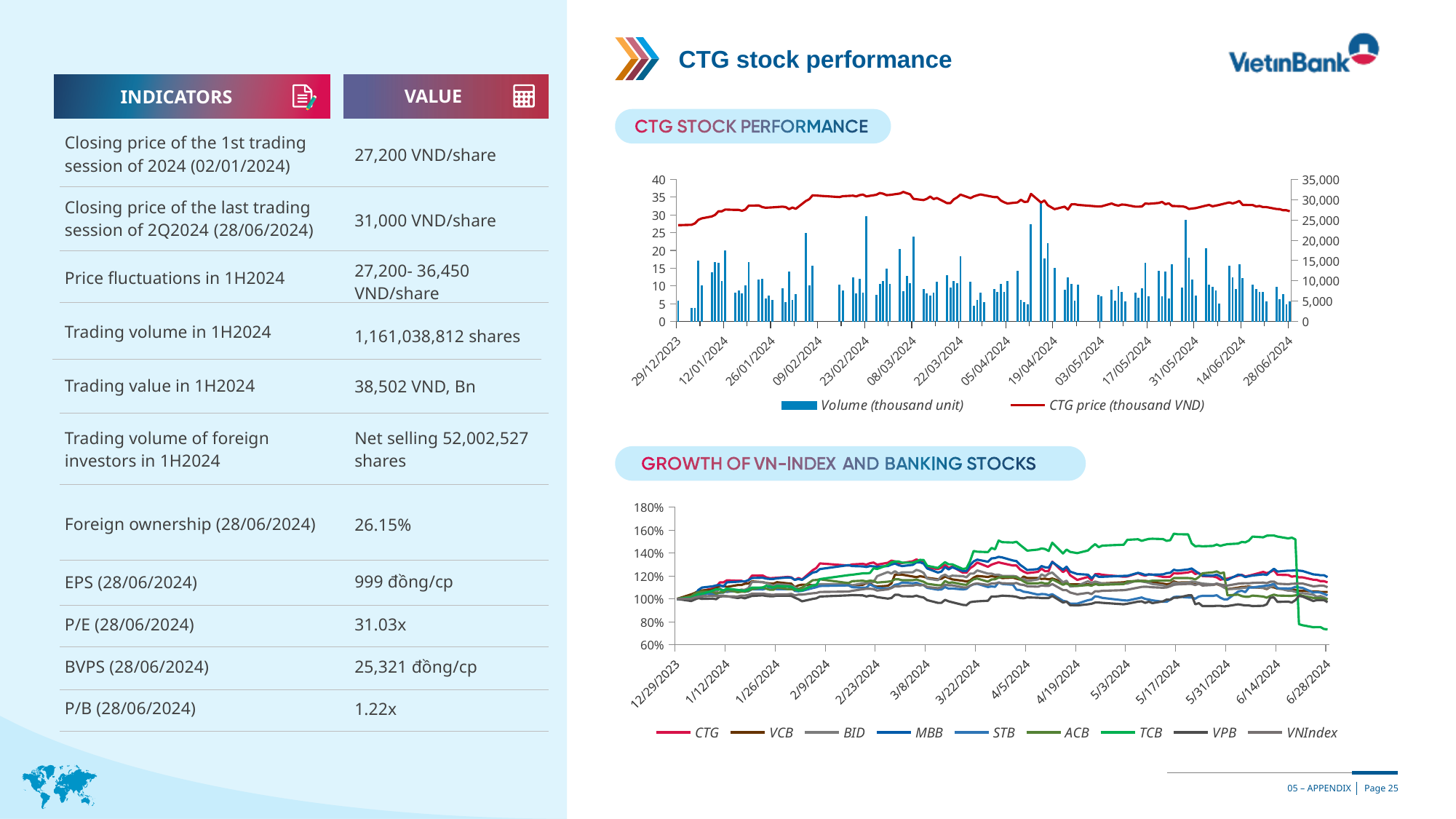
What kind of chart is the 'Growth of VN-Index and banking stocks' chart? Line chart In the 'Growth of VN-Index and banking stocks' chart, which series reaches the highest level around May 2024? TCB In the 'Growth of VN-Index and banking stocks' chart, is the TCB value around 5/17/2024 greater or less than 140%? greater What are the two legend entries of the 'CTG stock performance' chart? Volume (thousand unit) and CTG price (thousand VND) How many series does the legend of the 'CTG stock performance' chart list? 2 In the 'CTG stock performance' chart, does the CTG price rise or fall between 29/12/2023 and 09/02/2024? rise In the 'Growth of VN-Index and banking stocks' chart, which series is lowest around 3/22/2024? VPB In the 'Growth of VN-Index and banking stocks' chart, does the VNIndex series rise or fall between 12/29/2023 and 3/22/2024? rise How many series does the legend of the 'Growth of VN-Index and banking stocks' chart list? 9 In the 'Growth of VN-Index and banking stocks' chart, which series drops sharply to below 80% at the end of June 2024? TCB In the 'CTG stock performance' chart, is the CTG price at 29/12/2023 greater or less than 30,000 on the right axis? less